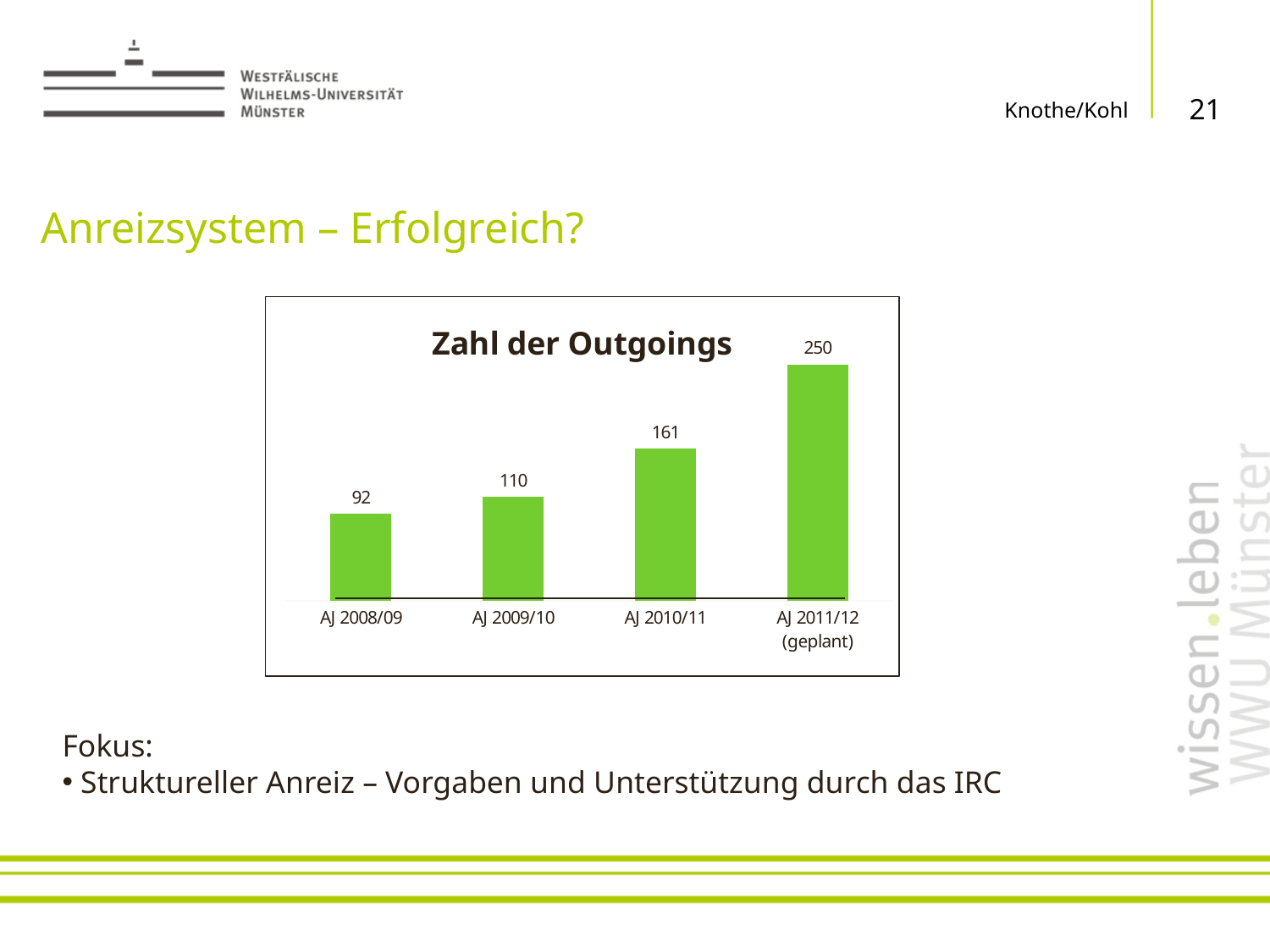
What kind of chart is shown? bar chart What is the value for AJ 2008/09? 92 Which category has the highest value? AJ 2011/12 (geplant) What is the difference between the values for AJ 2011/12 (geplant) and AJ 2010/11? 89 Which is larger, the value for AJ 2010/11 or AJ 2009/10? AJ 2010/11 What is the planned value for AJ 2011/12? 250 What is the value for AJ 2010/11? 161 What is the title of the chart? Zahl der Outgoings Which category has the lowest value? AJ 2008/09 What is the value for AJ 2009/10? 110 What is the difference between the values for AJ 2009/10 and AJ 2008/09? 18 How many categories are shown in the chart? 4